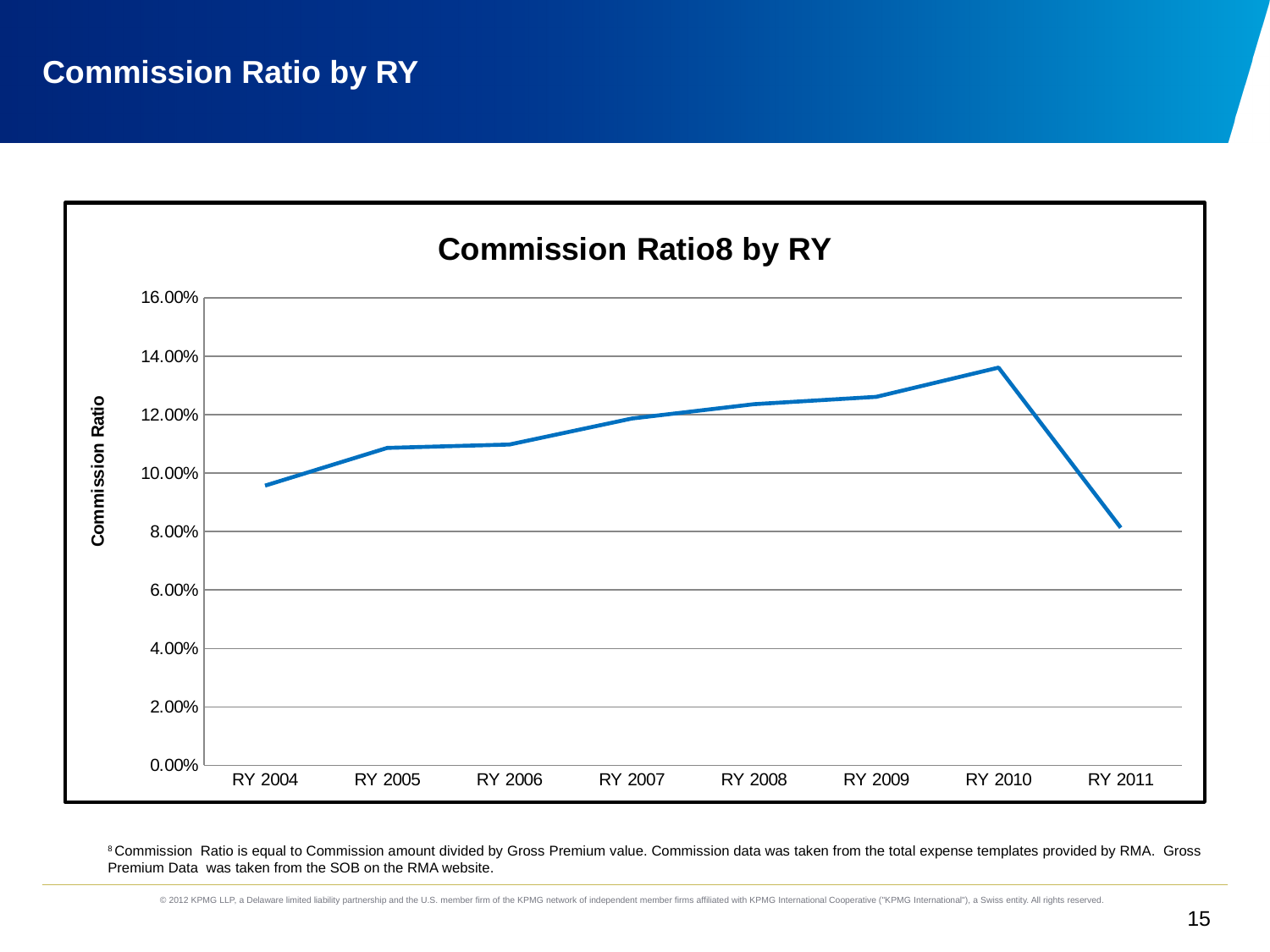
How many report years are plotted on the x axis? 8 Does the commission ratio rise or fall from RY 2004 to RY 2010? rise Is the commission ratio for RY 2004 greater or less than 10.00%? less Which has the larger commission ratio, RY 2004 or RY 2010? RY 2010 Which report year has the lowest commission ratio? RY 2011 Which report year has the highest commission ratio? RY 2010 Is the commission ratio for RY 2011 greater or less than 10.00%? less Is the commission ratio for RY 2010 greater or less than 12.00%? greater What is the title of the chart? Commission Ratio8 by RY What is the label on the vertical axis? Commission Ratio What kind of chart is shown on the slide? line chart